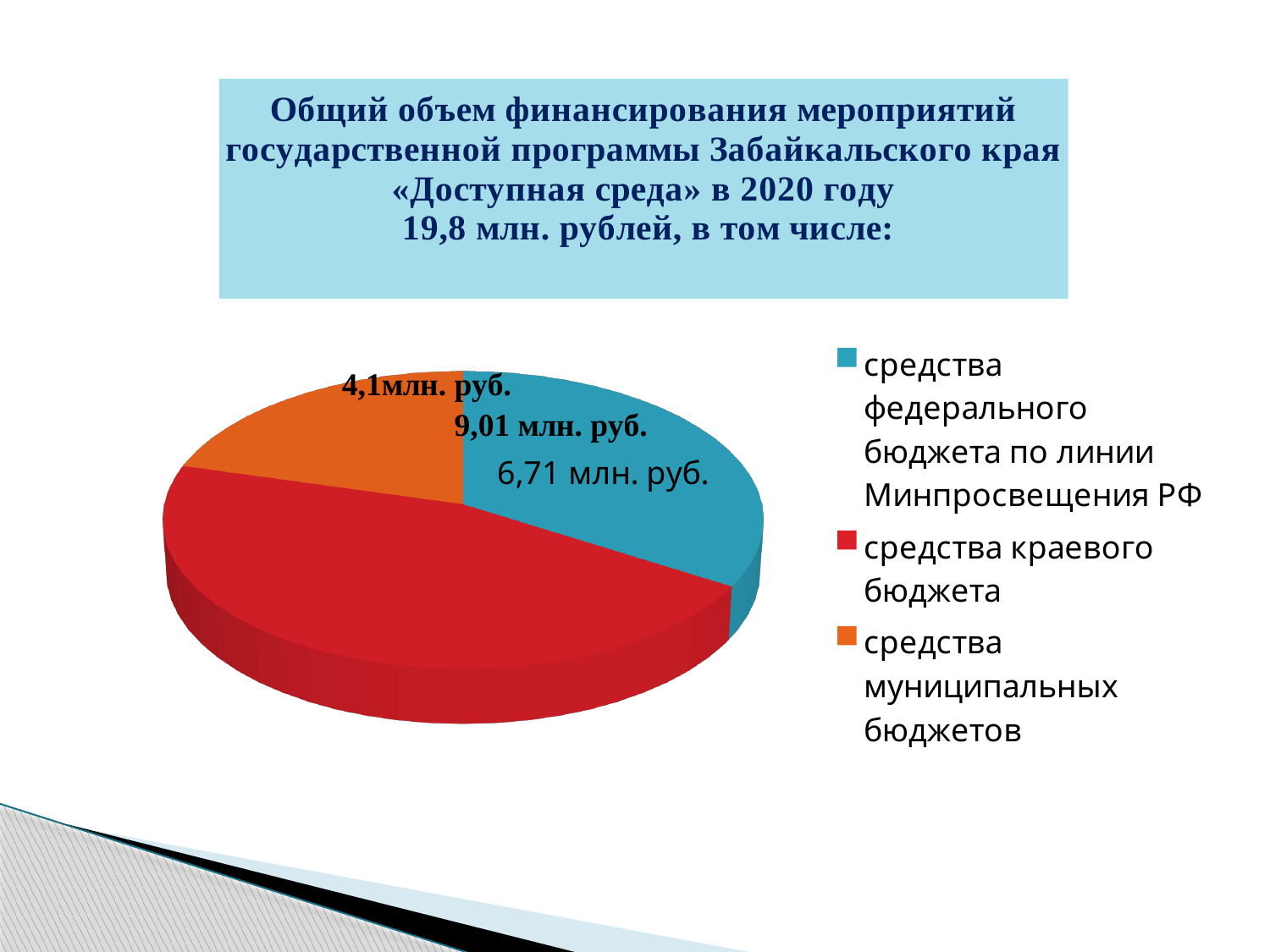
Which is larger: средства федерального бюджета по линии Минпросвещения РФ or средства муниципальных бюджетов? средства федерального бюджета по линии Минпросвещения РФ What is the value for средства краевого бюджета? 9,01 млн. руб. What total funding amount for 2020 is stated in the slide title? 19,8 млн. рублей Which funding source has the smallest slice of the pie? средства муниципальных бюджетов What is the value for средства федерального бюджета по линии Минпросвещения РФ? 6,71 млн. руб. What is the difference between средства краевого бюджета and средства федерального бюджета по линии Минпросвещения РФ? 2,3 млн. руб. What kind of chart is shown on the slide? pie chart What is the difference between средства федерального бюджета по линии Минпросвещения РФ and средства муниципальных бюджетов? 2,61 млн. руб. Which funding source has the largest slice of the pie? средства краевого бюджета What is the value for средства муниципальных бюджетов? 4,1 млн. руб. How many entries does the legend list? 3 How many slices does the pie chart have? 3